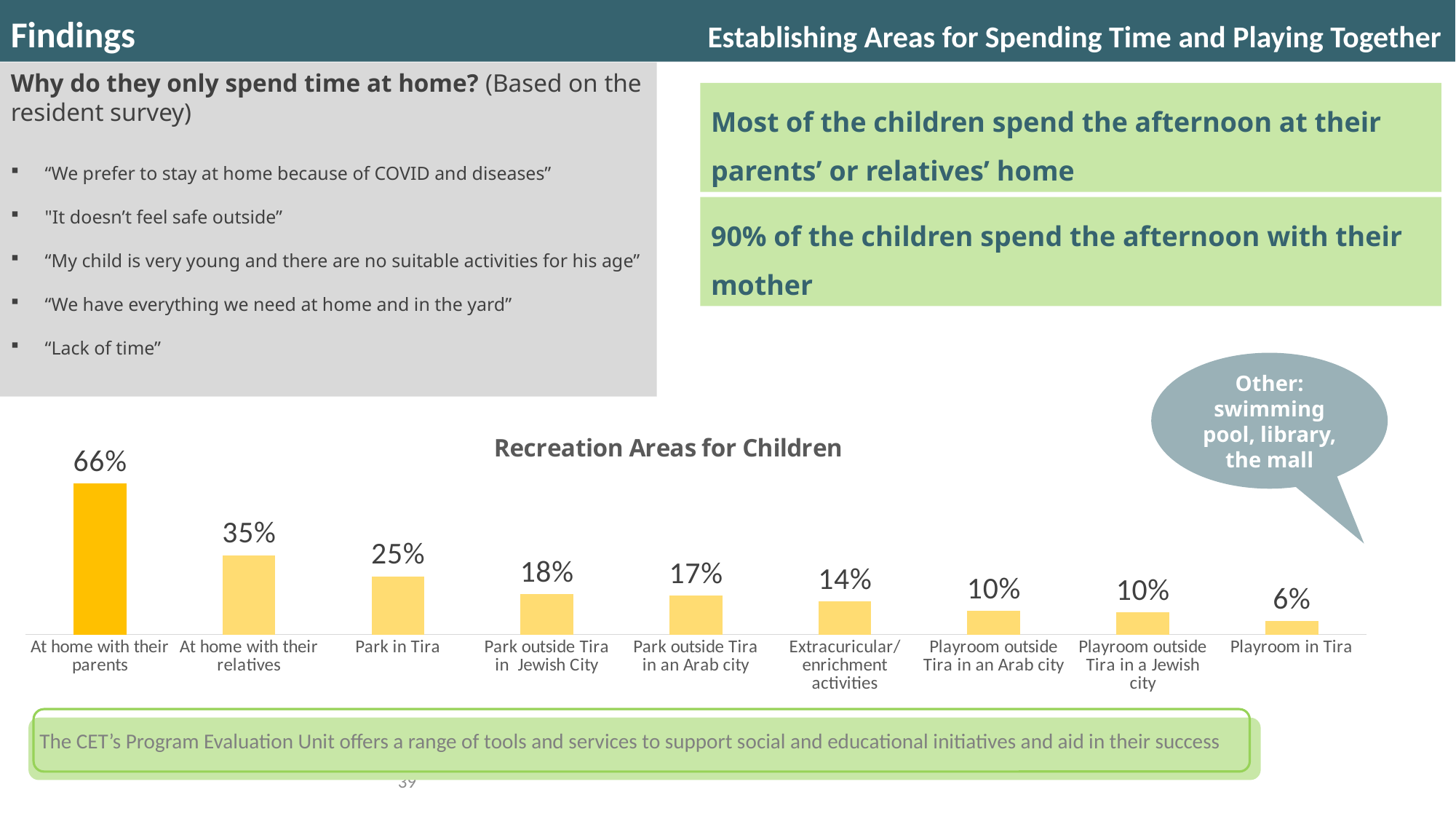
Do the values in the Recreation Areas for Children chart rise or fall from left to right? Fall What is the title of the chart on the slide? Recreation Areas for Children How many categories are shown in the Recreation Areas for Children chart? 9 What is the value for 'Park in Tira' in the Recreation Areas for Children chart? 25% Which category has the lowest value in the Recreation Areas for Children chart? Playroom in Tira Which is larger in the Recreation Areas for Children chart: 'Park in Tira' or 'Playroom in Tira'? Park in Tira What is the difference between 'At home with their parents' and 'At home with their relatives' in the Recreation Areas for Children chart? 31% What is the difference between 'Park outside Tira in Jewish City' and 'Park outside Tira in an Arab city' in the Recreation Areas for Children chart? 1% What is the value for 'At home with their parents' in the Recreation Areas for Children chart? 66% Which category has the highest value in the Recreation Areas for Children chart? At home with their parents What is the value for 'Extracuricular/enrichment activities' in the Recreation Areas for Children chart? 14% What kind of chart is the Recreation Areas for Children chart? Bar chart